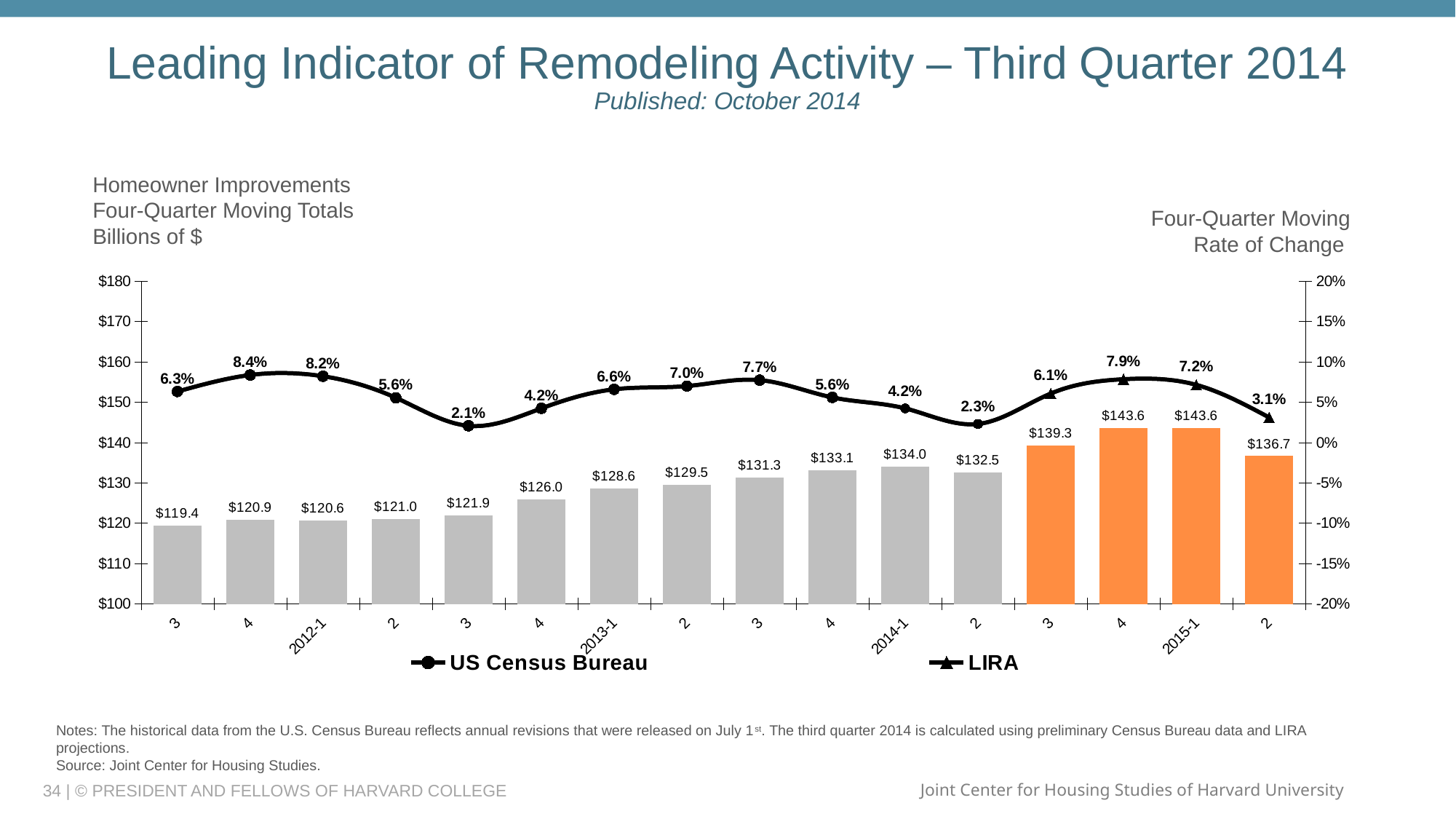
What is the lowest four-quarter moving total shown on the chart? $119.4 How many series does the legend list? 2 What is the four-quarter moving total for 2014-1? $134.0 How many bars are plotted on the chart? 16 What is the four-quarter moving total for 2015-1? $143.6 What is the four-quarter moving rate of change shown for 2013-1? 6.6% What is the highest four-quarter moving rate of change shown on the chart? 8.4% What is the difference between the four-quarter moving totals for 2014-1 and 2013-1? $5.4 What is the lowest four-quarter moving rate of change shown on the chart? 2.1% Which is larger, the four-quarter moving total for 2012-1 or for 2013-1? 2013-1 What kind of chart is shown on the slide? Combination bar and line chart Do the four-quarter moving totals rise or fall from 2012-1 to 2014-1? Rise